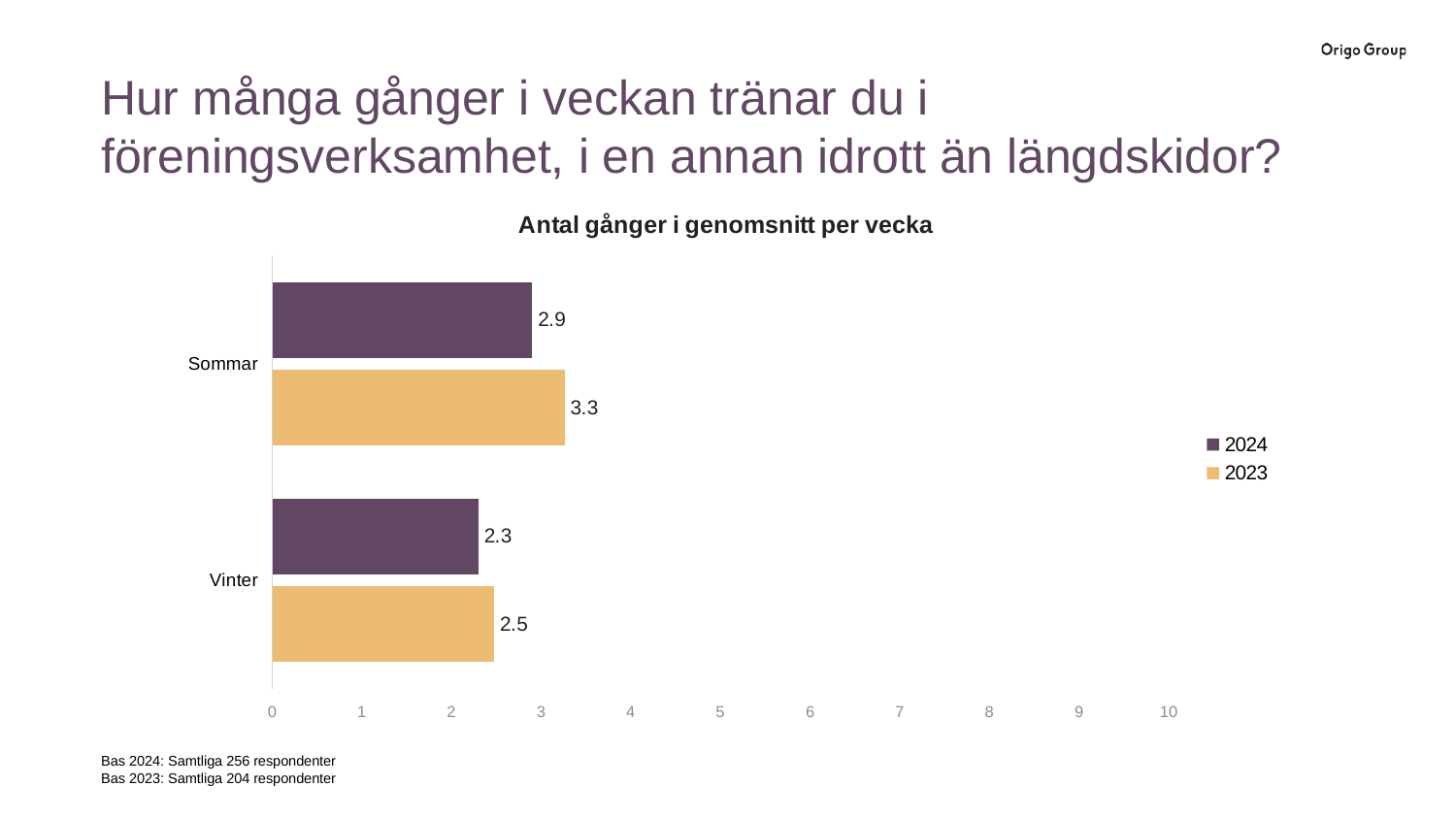
How many categories are shown on the chart? 2 Which is larger for Vinter, the 2024 value or the 2023 value? 2023 What is the value for Sommar in the 2024 series? 2.9 Which bar has the lowest value on the chart? Vinter, 2024 What is the value for Vinter in the 2024 series? 2.3 What kind of chart is shown on the slide? Bar chart What is the value for Sommar in the 2023 series? 3.3 Which bar has the highest value on the chart? Sommar, 2023 How many series does the legend list? 2 What is the difference between the 2023 and 2024 values for Vinter? 0.2 What is the value for Vinter in the 2023 series? 2.5 What is the difference between the 2023 and 2024 values for Sommar? 0.4